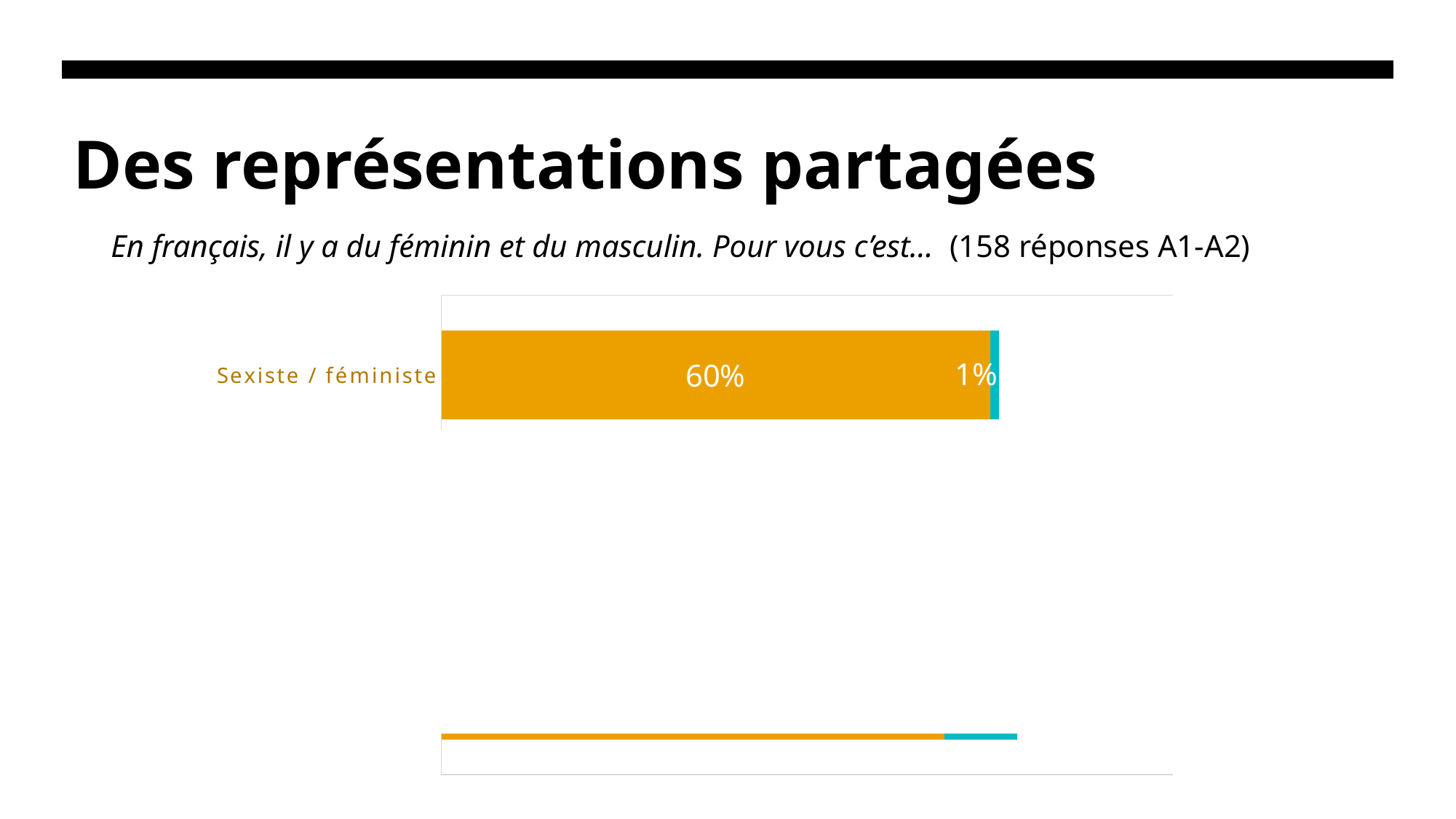
Which labelled value in the chart is the lowest? 1% What is the title of the slide? Des représentations partagées Which labelled value in the chart is the highest? 60% What is the category label shown on the chart? Sexiste / féministe What is the difference between the two labelled values in the "Sexiste / féministe" bar? 59% What is the value of the orange segment for "Sexiste / féministe"? 60% Which segment of the "Sexiste / féministe" bar is larger, the orange one or the teal one? The orange one What kind of chart is shown on the slide? Bar chart What is the value of the teal segment for "Sexiste / féministe"? 1% What is the total of the two labelled segments in the "Sexiste / féministe" bar? 61%